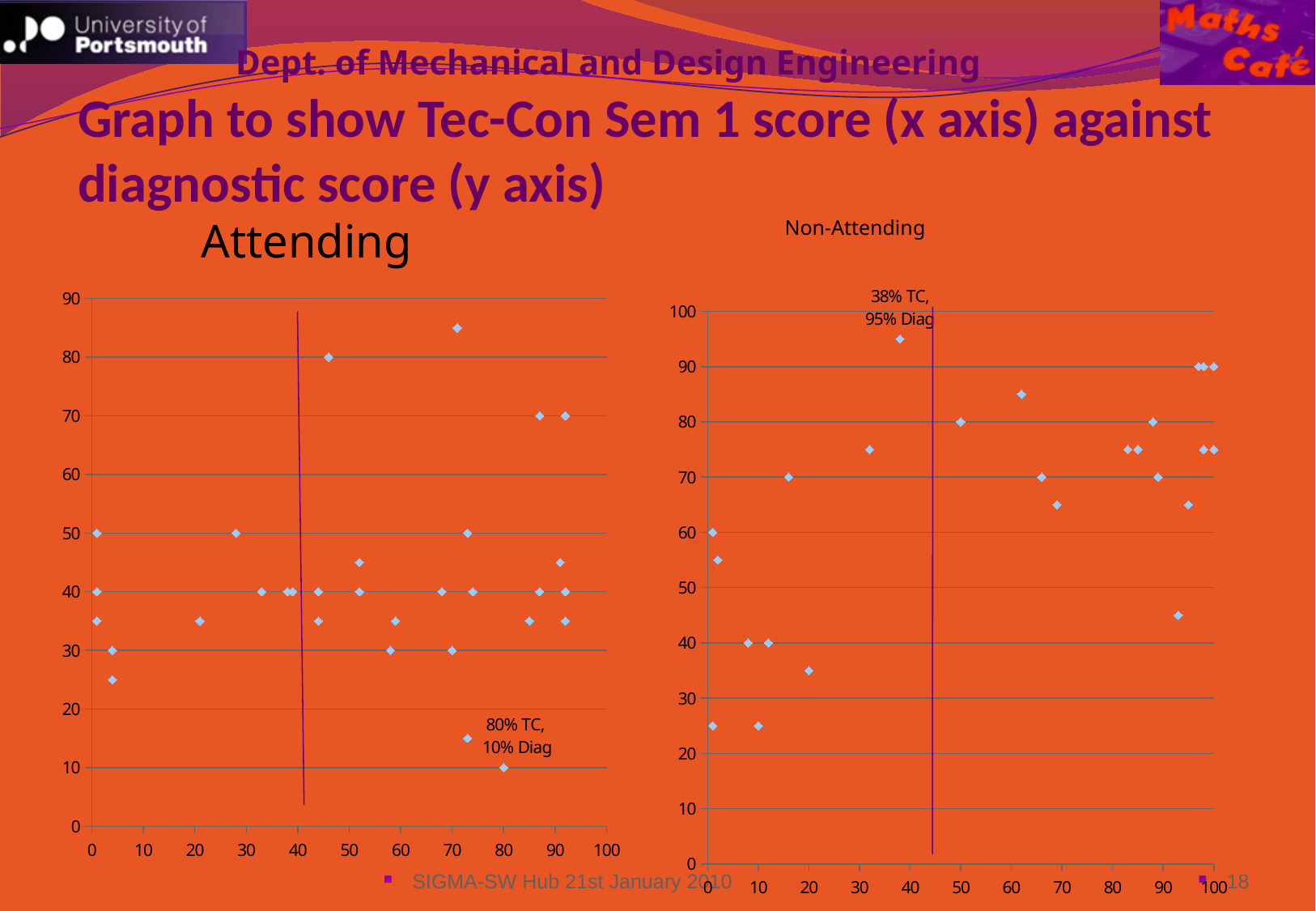
On the Attending chart, is the diagnostic score of the highest point greater or less than 80? greater On the Attending chart, what diagnostic score is given in the annotation for the labelled point? 10% Diag What is the highest value shown on the y axis of the Attending chart? 90 What kind of chart is the Attending chart? scatter chart On the Attending chart, what Tec-Con score is given in the annotation for the labelled point? 80% TC What kind of chart is the Non-Attending chart? scatter chart On the Non-Attending chart, is the diagnostic score of the lowest point greater or less than 30? less On the Non-Attending chart, what Tec-Con score is given in the annotation for the labelled point? 38% TC Which chart has the higher maximum value on its y axis, Attending or Non-Attending? Non-Attending On the Non-Attending chart, what diagnostic score is given in the annotation for the labelled point? 95% Diag What is the title of the chart on the right of the slide? Non-Attending